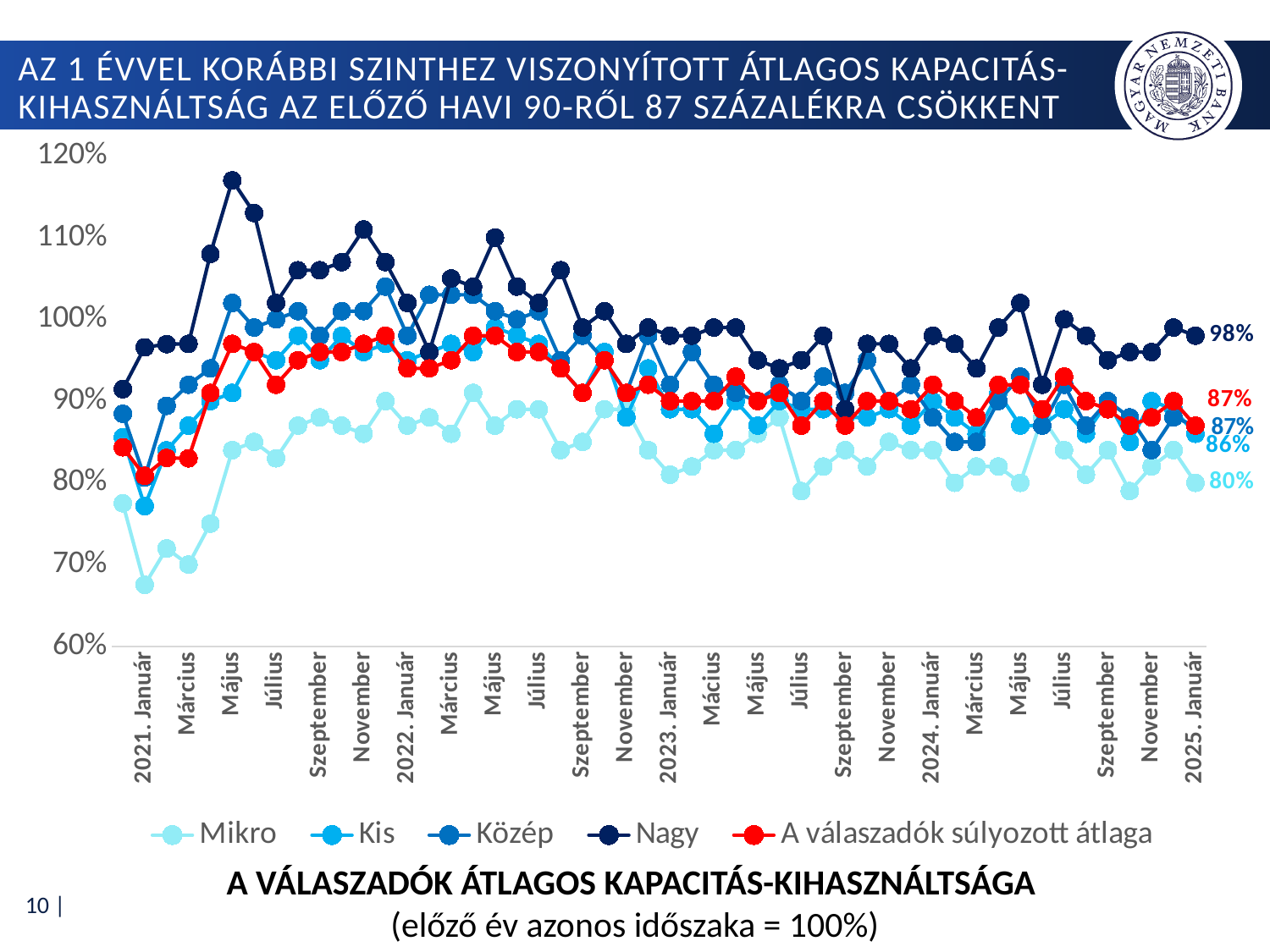
What is the value of the Mikro series at 2025. Január? 80% What is the value of the Nagy series at 2025. Január? 98% Is the value of the Nagy series in Május 2021 greater or less than 110%? greater What is the difference between the Nagy and Mikro values at 2025. Január? 18 percentage points Which series has the lowest value at 2025. Január? Mikro Which series has the highest value at 2025. Január? Nagy What is the value of the Kis series at 2025. Január? 86% What is the title printed below the chart? A válaszadók átlagos kapacitás-kihasználtsága (előző év azonos időszaka = 100%) Between 2022. Január and 2025. Január, does the Nagy series generally rise or fall? fall How many series does the legend list? 5 What kind of chart is shown on the slide? line chart What is the value of 'A válaszadók súlyozott átlaga' at 2025. Január? 87%